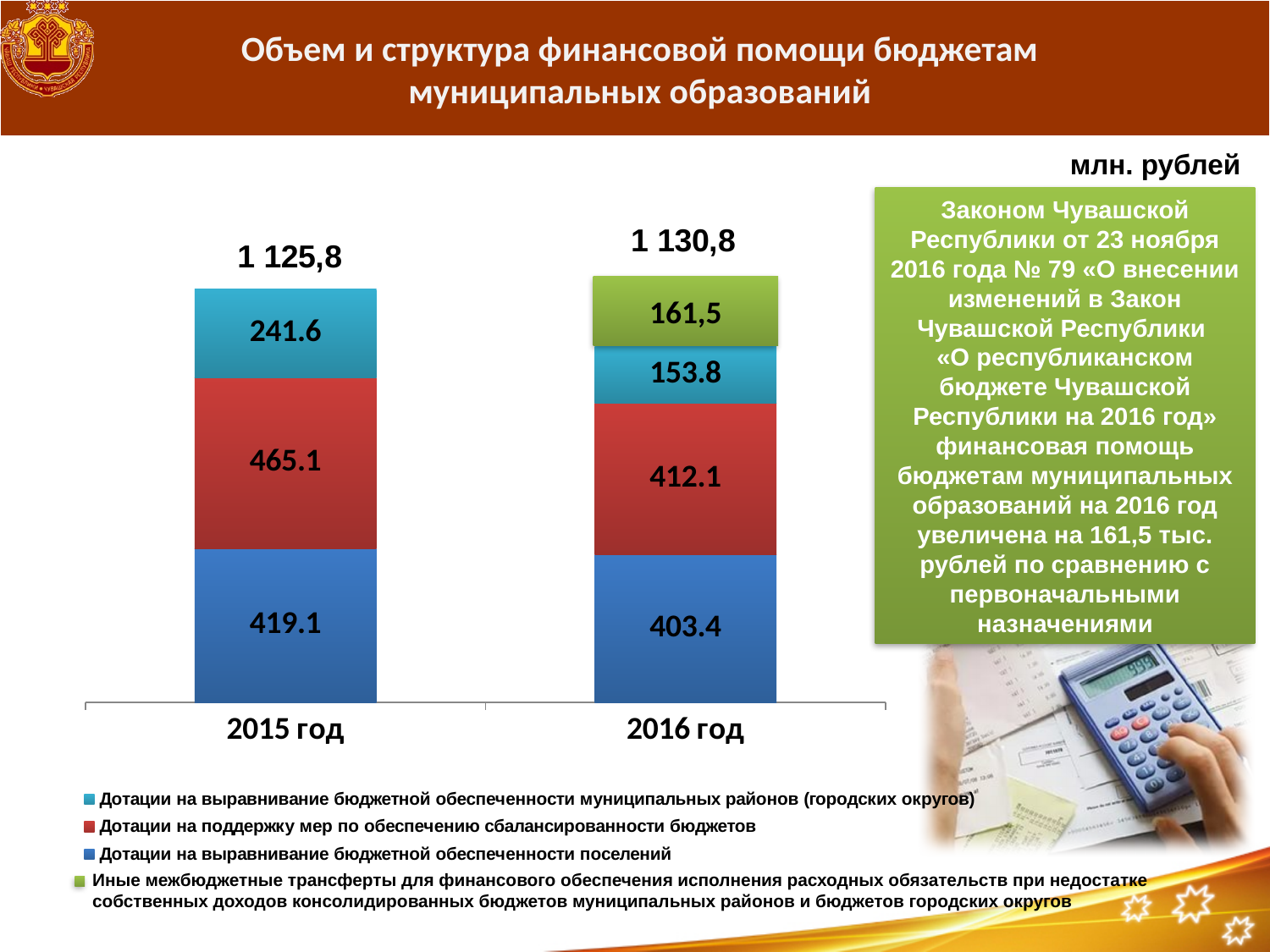
What type of chart is shown on the slide? stacked bar chart Which year has the larger value for 'Дотации на выравнивание бюджетной обеспеченности муниципальных районов (городских округов)', 2015 год or 2016 год? 2015 год What is the difference between the 2015 and 2016 values of 'Дотации на поддержку мер по обеспечению сбалансированности бюджетов'? 53.0 What is the value of 'Иные межбюджетные трансферты...' (the green segment) for 2016 год? 161,5 What is the value of 'Дотации на выравнивание бюджетной обеспеченности поселений' for 2015 год? 419.1 What is the value of 'Дотации на выравнивание бюджетной обеспеченности муниципальных районов (городских округов)' for 2015 год? 241.6 What unit is stated for the values in the chart? млн. рублей How many categories (years) are shown on the x axis of the chart? 2 Which segment is the largest in the 2015 год bar? Дотации на поддержку мер по обеспечению сбалансированности бюджетов What is the value of 'Дотации на поддержку мер по обеспечению сбалансированности бюджетов' for 2016 год? 412.1 What is the total of the stacked bar for 2016 год? 1 130,8 How many series does the legend of the chart list? 4